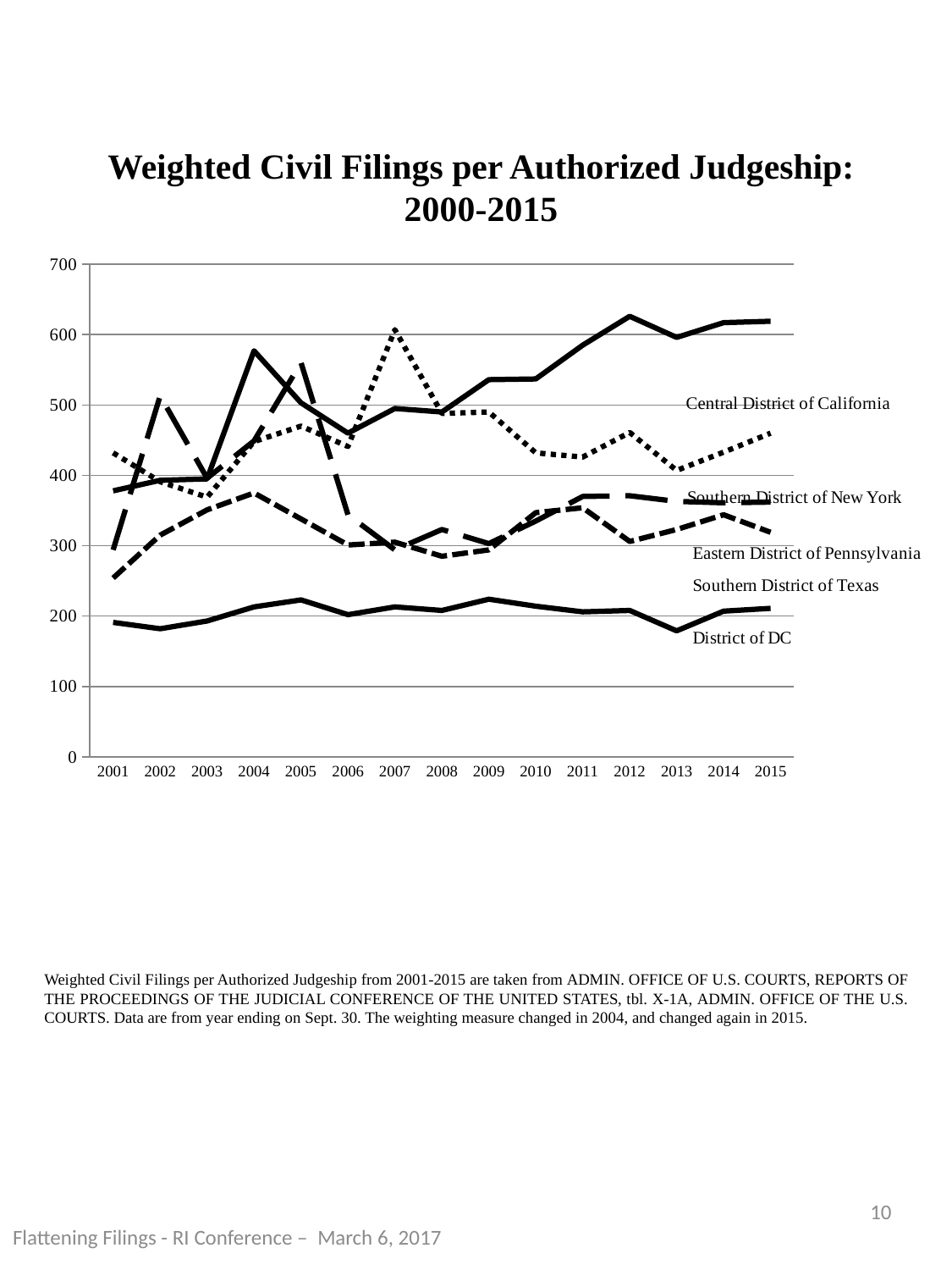
How many districts (series) are plotted on the chart? 5 How many years are shown along the x axis of the chart? 15 What kind of chart is shown on the slide? line chart What is the title of the chart? Weighted Civil Filings per Authorized Judgeship: 2000-2015 Is the value for Central District of California in 2012 greater or less than 600? greater What is the first year shown on the x axis? 2001 Which is larger in 2015, the value for Central District of California or the value for District of DC? Central District of California Which district has the highest weighted civil filings per authorized judgeship in 2015? Central District of California Is the value for District of DC in 2009 greater or less than 300? less Which district has the lowest weighted civil filings per authorized judgeship in 2015? District of DC Does the line for District of DC rise or fall from 2013 to 2014? rise Is the value for District of DC in 2013 greater or less than 200? less